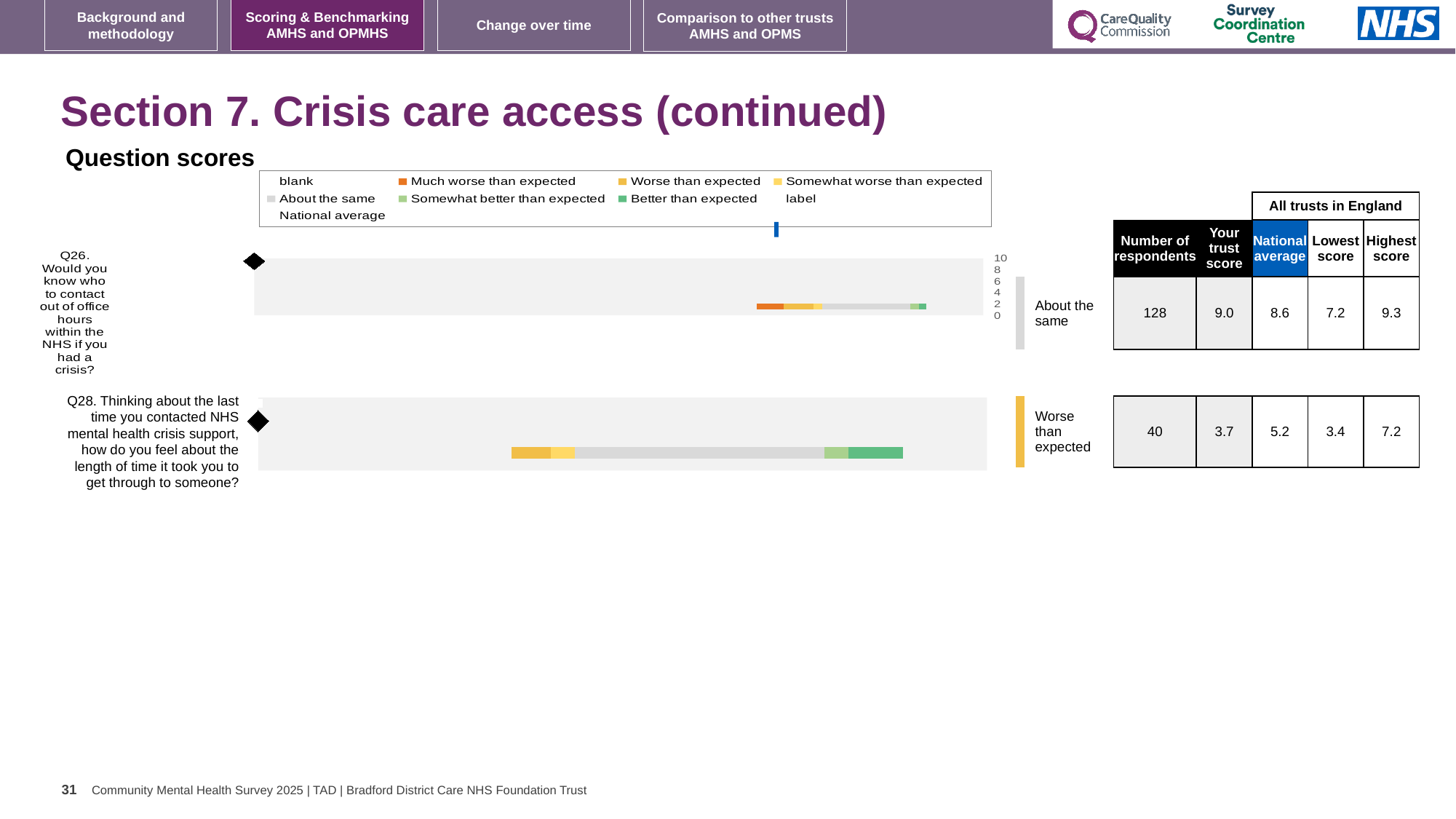
Is the trust score for Q28 greater or less than 4? less What kind of chart is used to show the question scores on this slide? bar chart Which benchmark category is Q28 placed in? Worse than expected How many respondents answered Q26? 128 For Q26, is the trust score or the national average higher? trust score Which benchmark category is Q26 placed in? About the same What is the national average for Q28 (length of time it took to get through to someone)? 5.2 What is the difference between the trust score and the national average for Q26? 0.4 What is the lowest score among all trusts in England for Q28? 3.4 What is the difference between the highest and lowest scores for Q28? 3.8 How many questions are plotted in the question scores chart? 2 What is the trust score for Q26 (Would you know who to contact out of office hours within the NHS if you had a crisis?)? 9.0